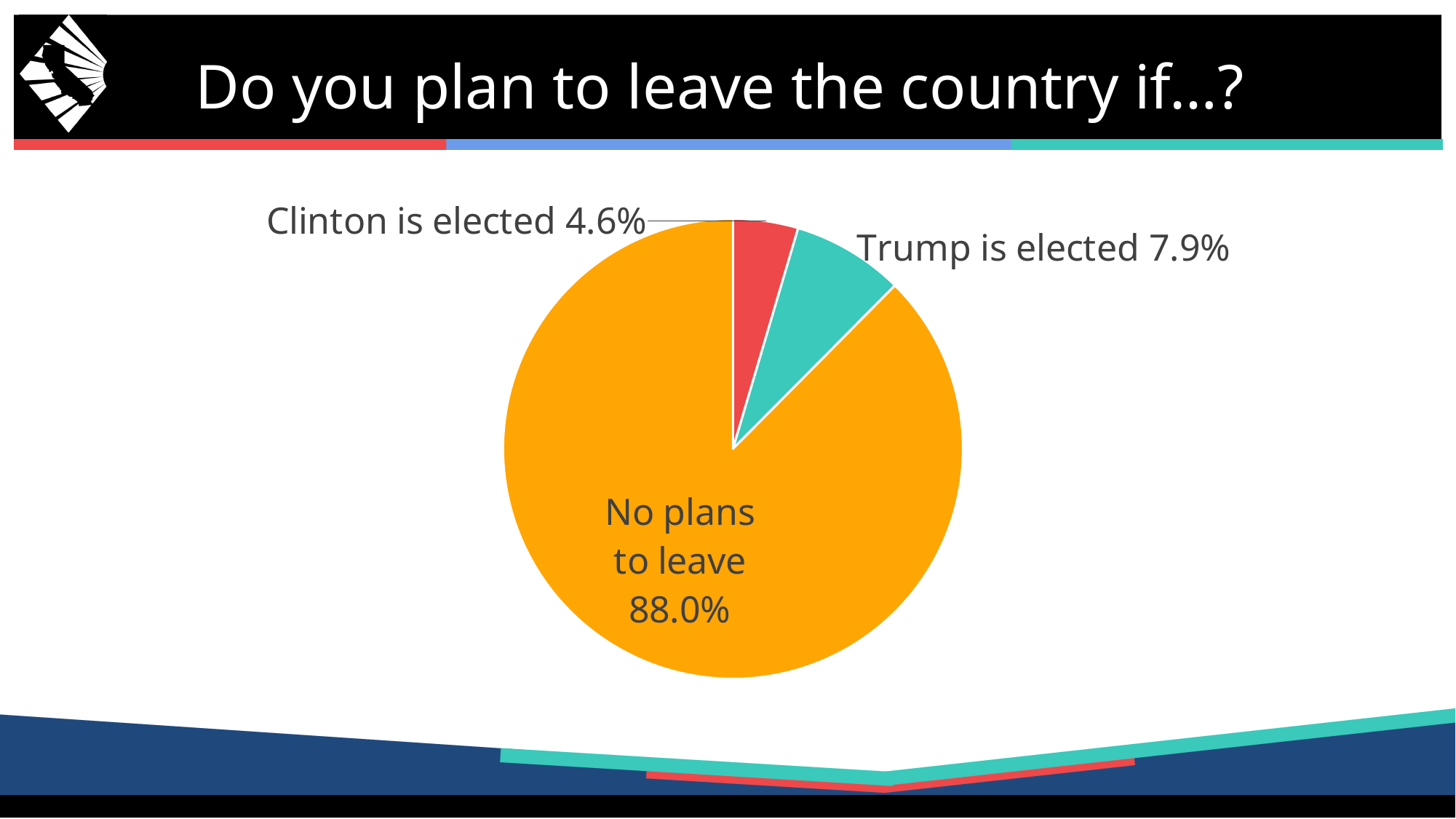
What is the title of the slide containing the pie chart? Do you plan to leave the country if...? Which slice of the pie is the largest? No plans to leave What is the difference in percentage points between 'Trump is elected' and 'Clinton is elected'? 3.3 Which slice of the pie is the smallest? Clinton is elected What percentage of respondents said they plan to leave the country if Clinton is elected? 4.6% What colour is the 'No plans to leave' slice? orange What kind of chart is shown on the slide? pie chart Which is larger: the share for 'Trump is elected' or the share for 'Clinton is elected'? Trump is elected What percentage of respondents said they plan to leave the country if Trump is elected? 7.9% What percentage of respondents have no plans to leave? 88.0% What is the combined share of respondents who plan to leave if either Clinton or Trump is elected? 12.5% How many slices does the pie chart have? 3